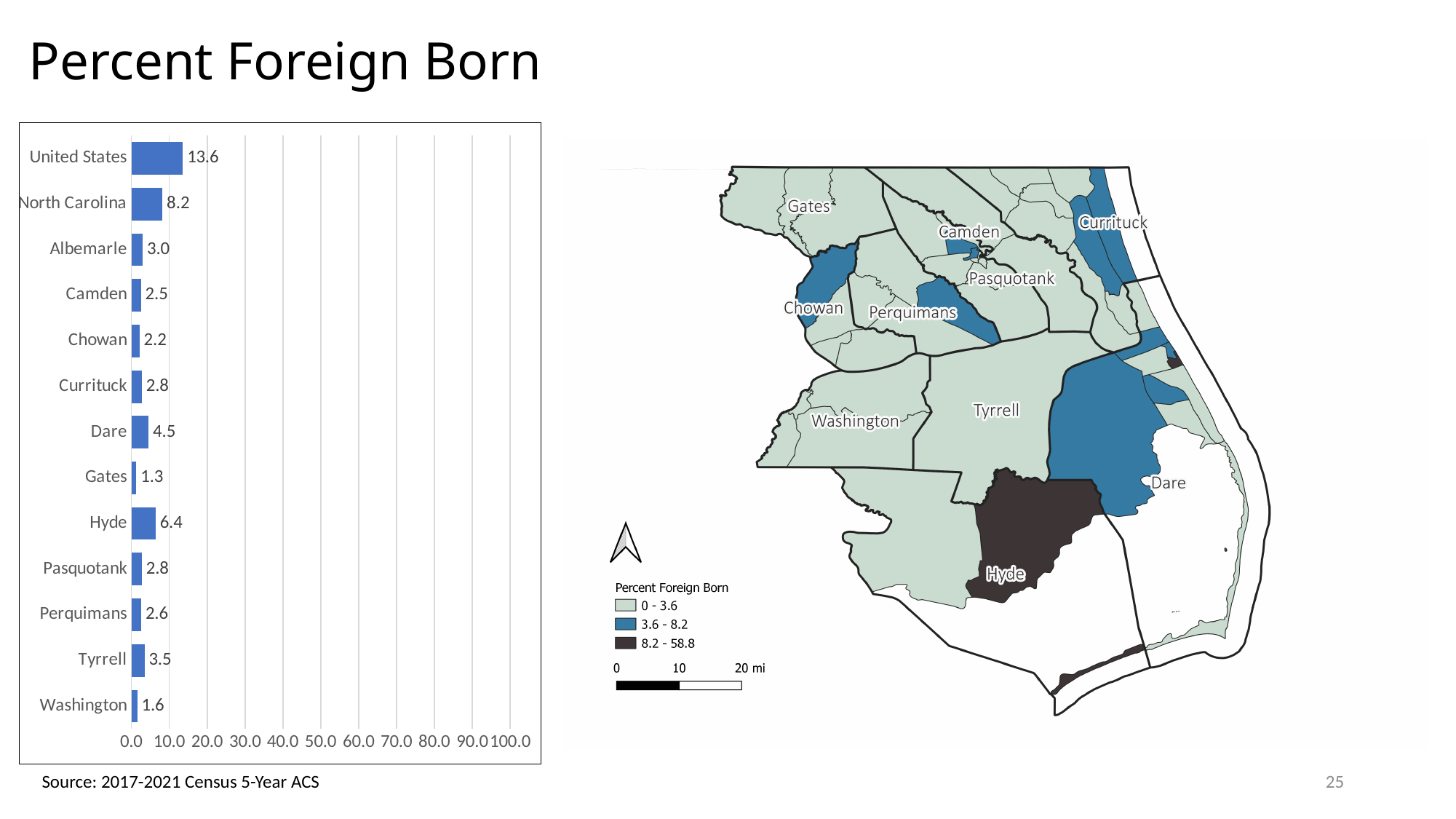
Which category has the highest value in the bar chart? United States What is the source cited for the data on the slide? 2017-2021 Census 5-Year ACS Is the value for the United States greater or less than 10.0? greater What is the difference between the Hyde value and the Dare value? 1.9 What kind of chart is shown on the left of the slide? Bar chart How many categories are shown in the bar chart? 13 What is the value shown for Hyde in the bar chart? 6.4 Which has a larger value, Tyrrell or Albemarle? Tyrrell What is the percent foreign born value shown for the United States? 13.6 What is the value shown for Dare in the bar chart? 4.5 Which category has the lowest value in the bar chart? Gates What is the difference between the United States value and the North Carolina value? 5.4